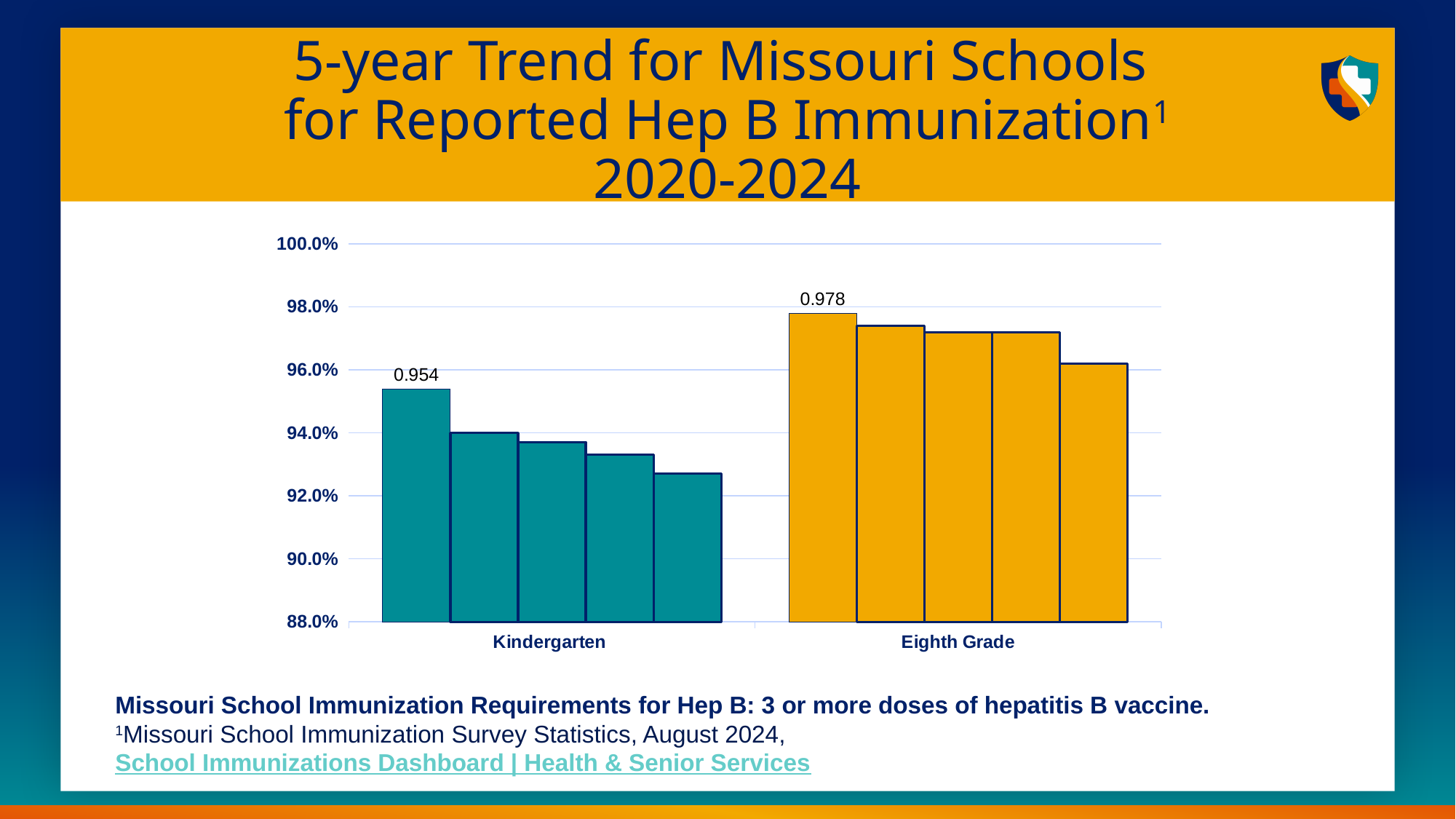
How many categories are labelled on the x axis of the chart? 2 Which is larger, the labelled first Kindergarten bar or the labelled first Eighth Grade bar? Eighth Grade What is the highest value shown on the y axis of the chart? 100.0% What value is labelled on the first (tallest) Kindergarten bar? 0.954 Which category contains the shortest bar on the chart? Kindergarten Is the value of the last (rightmost) Kindergarten bar greater or less than 94.0%? less How many bars are plotted for the Kindergarten category? 5 What is the difference between the labelled Eighth Grade value (0.978) and the labelled Kindergarten value (0.954)? 0.024 Which category contains the tallest bar on the chart? Eighth Grade Within the Kindergarten group, do the bars rise or fall from left to right? Fall What kind of chart is shown on the slide? Bar chart What value is labelled on the first (tallest) Eighth Grade bar? 0.978